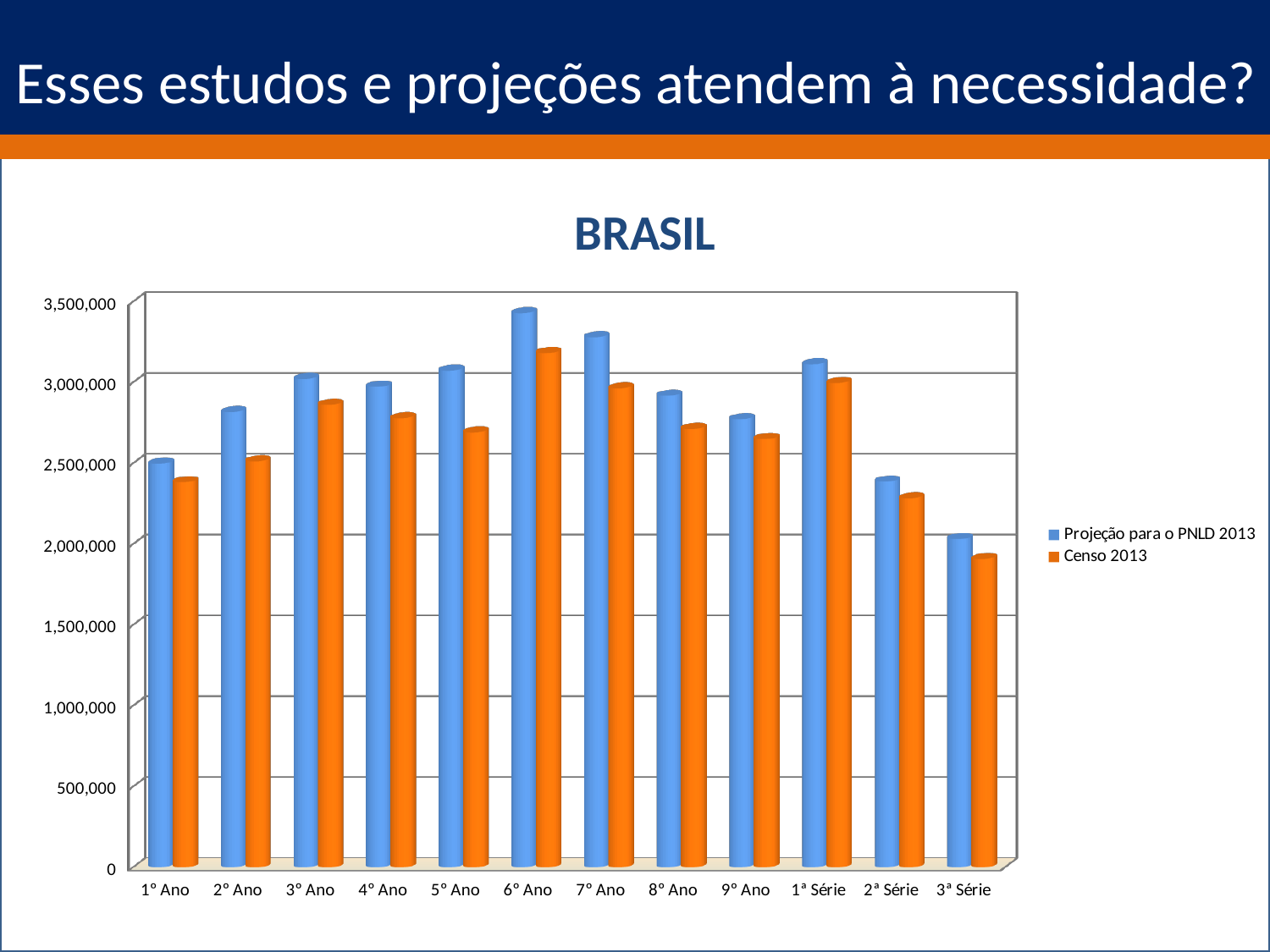
Is the Censo 2013 value for 3ª Série greater or less than 2,000,000? less Is the Censo 2013 value for 1° Ano greater or less than 2,500,000? less What is the title of the chart? BRASIL What type of chart is shown on the slide? bar chart Which category has the lowest value for Projeção para o PNLD 2013? 3ª Série Which category has the lowest value for Censo 2013? 3ª Série Is the Censo 2013 value for 5° Ano greater or less than 3,000,000? less How many categories are shown on the x axis? 12 Which category has the highest value for Projeção para o PNLD 2013? 6° Ano For 6° Ano, which series has the larger value: Projeção para o PNLD 2013 or Censo 2013? Projeção para o PNLD 2013 How many series does the legend list? 2